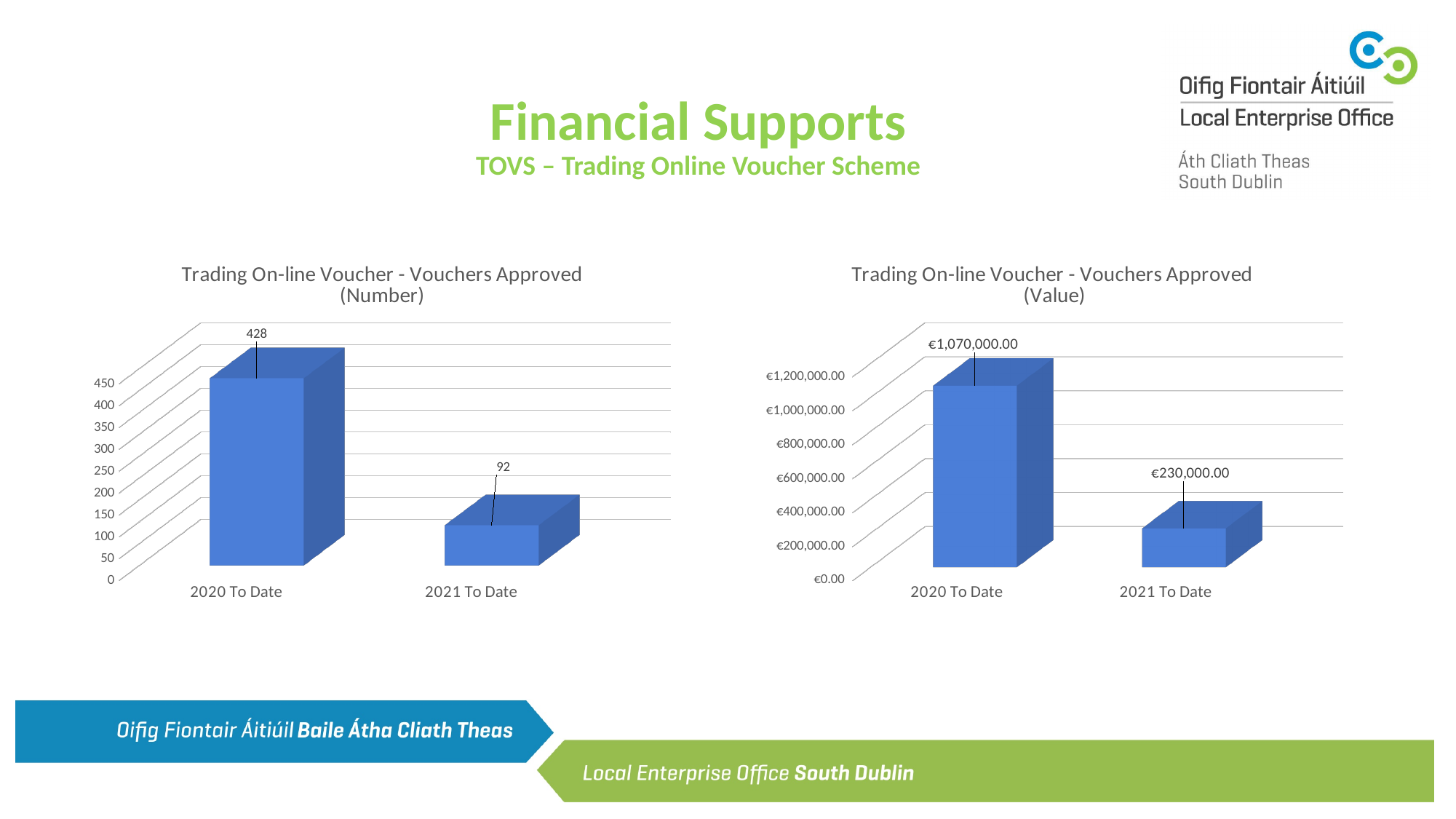
In the 'Trading On-line Voucher - Vouchers Approved (Number)' chart, which category has the highest value? 2020 To Date In the 'Trading On-line Voucher - Vouchers Approved (Number)' chart, do the values rise or fall from 2020 To Date to 2021 To Date? Fall In the 'Trading On-line Voucher - Vouchers Approved (Value)' chart, what is the value for 2020 To Date? €1,070,000.00 In the 'Trading On-line Voucher - Vouchers Approved (Value)' chart, is the value for 2020 To Date greater or less than €1,000,000.00? greater In the 'Trading On-line Voucher - Vouchers Approved (Value)' chart, what is the difference between the 2020 To Date and 2021 To Date values? €840,000.00 In the 'Trading On-line Voucher - Vouchers Approved (Number)' chart, what is the value for 2020 To Date? 428 In the 'Trading On-line Voucher - Vouchers Approved (Value)' chart, what is the value for 2021 To Date? €230,000.00 In the 'Trading On-line Voucher - Vouchers Approved (Number)' chart, what is the difference between the 2020 To Date and 2021 To Date values? 336 In the 'Trading On-line Voucher - Vouchers Approved (Value)' chart, which category has the lowest value? 2021 To Date What kind of chart is the 'Trading On-line Voucher - Vouchers Approved (Value)' chart? Bar chart In the 'Trading On-line Voucher - Vouchers Approved (Number)' chart, what is the value for 2021 To Date? 92 How many categories are shown in the 'Trading On-line Voucher - Vouchers Approved (Number)' chart? 2